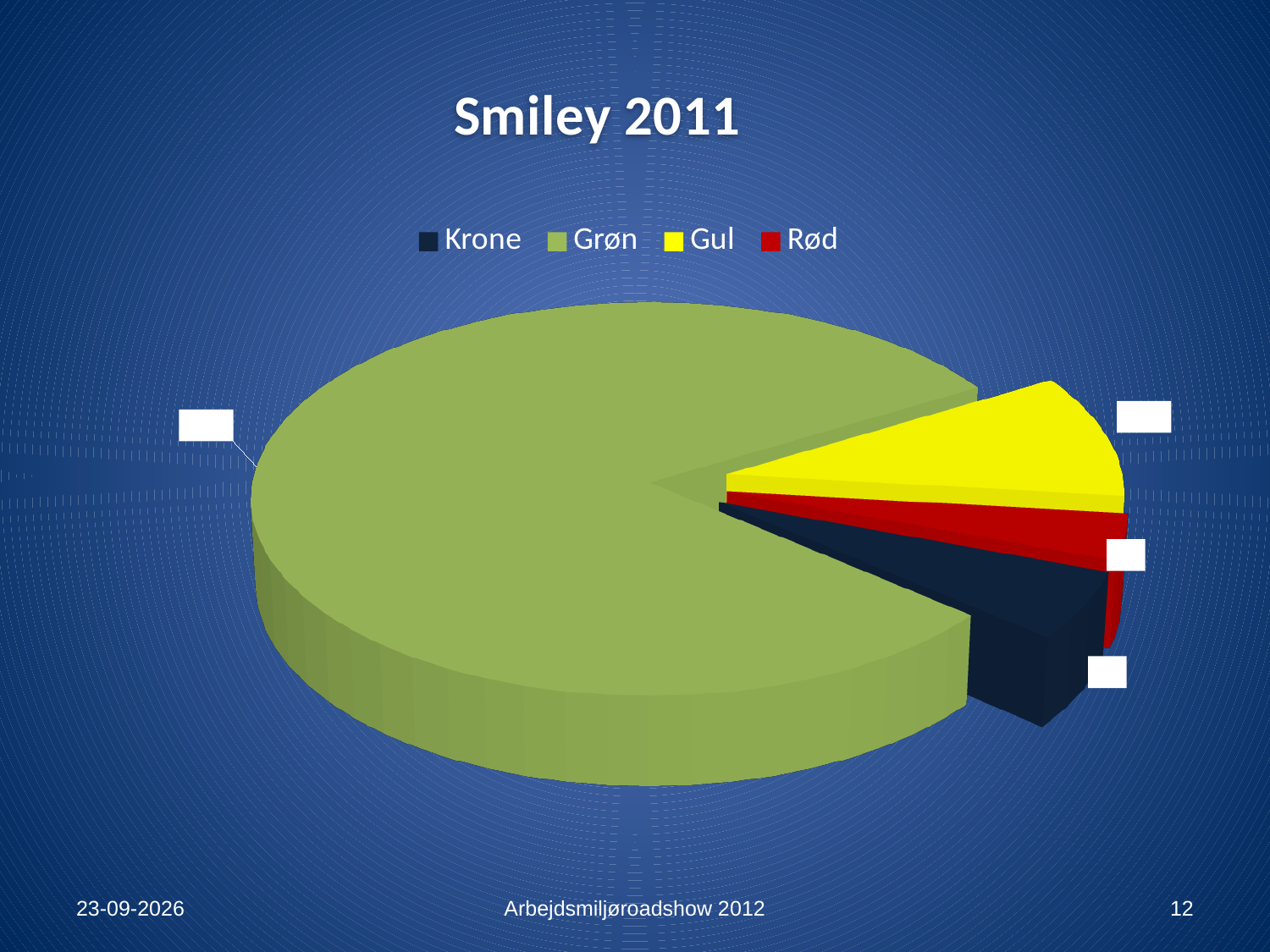
Which slice is larger, Gul or Rød? Gul What kind of chart is shown on the slide? pie chart Which slice is larger, Grøn or Gul? Grøn Which colour represents the Gul category in the pie chart? yellow How many categories does the legend of the pie chart list? 4 Which category has the largest slice of the pie? Grøn What is the title of the chart? Smiley 2011 Is the share of the Grøn slice greater or less than 50% of the pie? greater